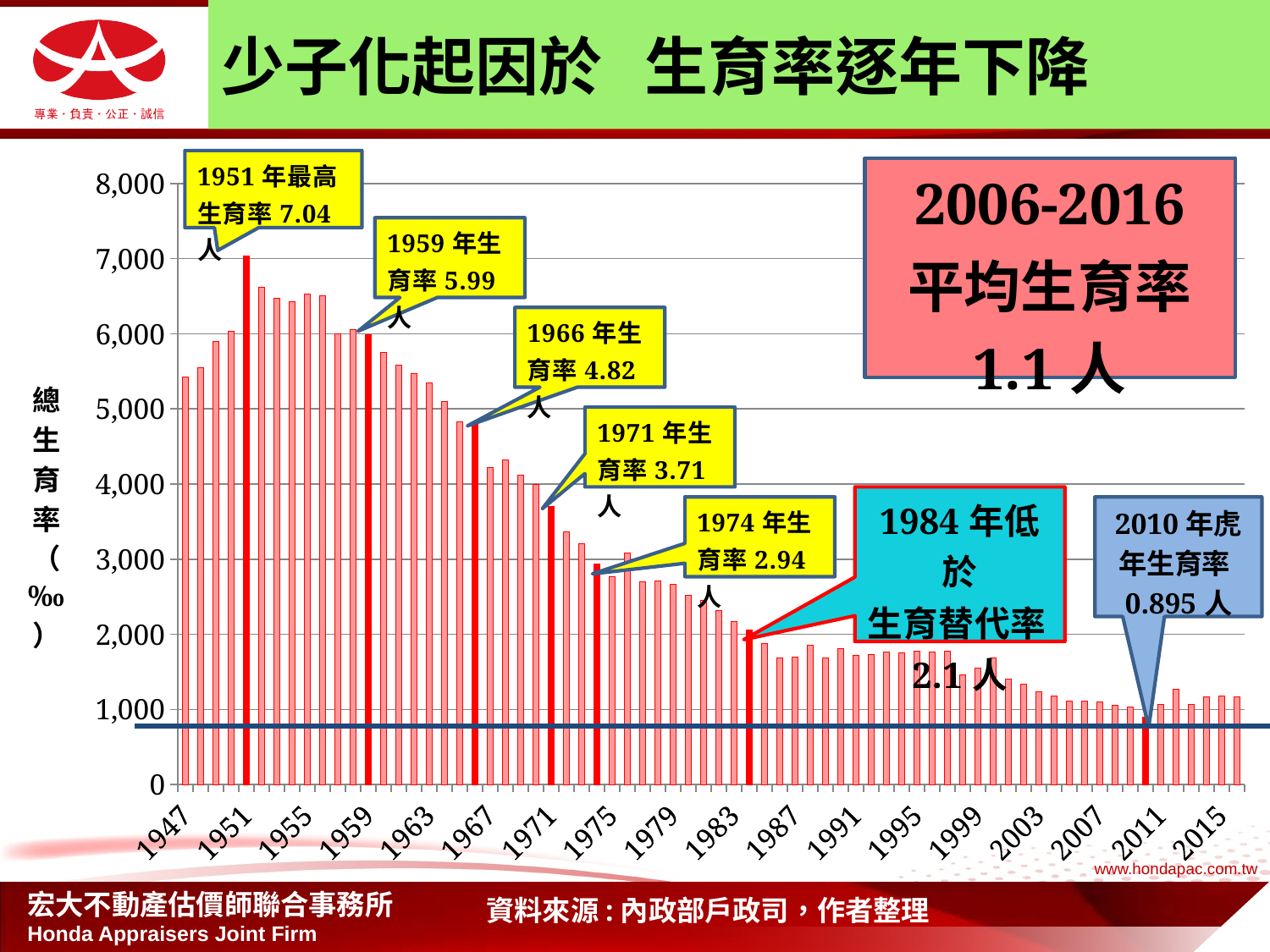
Is the value for 1987 greater or less than 2,000? less According to the callout, what was the fertility rate in 1974? 2.94 人 According to the callout, what was the fertility rate in 1966? 4.82 人 What is the difference between the 1951 fertility rate and the 1959 fertility rate shown in the callouts? 1.05 人 What average fertility rate for 2006-2016 is stated in the box on the slide? 1.1 人 Is the value for 1947 greater or less than 5,000? greater According to the callout, what was the fertility rate in 1951? 7.04 人 Which year has the highest total fertility rate in the chart? 1951 According to the callout, what was the fertility rate in 1959? 5.99 人 Overall, do the values rise or fall from 1947 to 2015 along the x axis? fall What kind of chart is shown on the slide? bar chart According to the callout, what was the fertility rate in 2010? 0.895 人